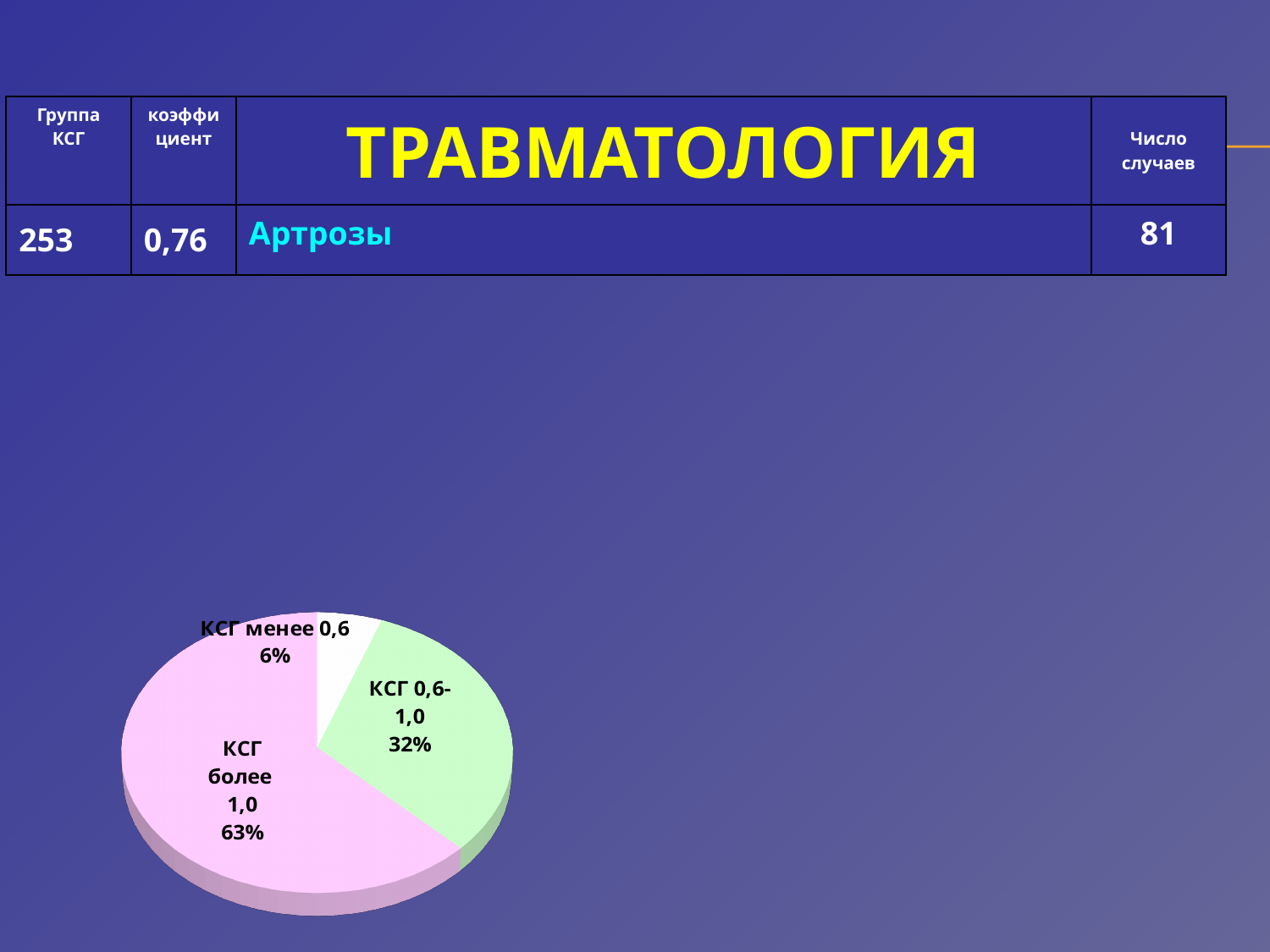
How many slices does the pie chart have? 3 Which slice of the pie chart is the largest? КСГ более 1,0 What kind of chart is shown on the slide? pie chart What is the difference in percentage points between the "КСГ 0,6-1,0" slice and the "КСГ менее 0,6" slice? 26 What is the difference in percentage points between the "КСГ более 1,0" slice and the "КСГ 0,6-1,0" slice? 31 What share of the pie does the slice "КСГ более 1,0" represent? 63% What share of the pie does the slice "КСГ 0,6-1,0" represent? 32% Which slice is larger: "КСГ 0,6-1,0" or "КСГ менее 0,6"? КСГ 0,6-1,0 What colour is the "КСГ 0,6-1,0" slice in the pie chart? light green What colour is the "КСГ более 1,0" slice in the pie chart? pink What share of the pie does the slice "КСГ менее 0,6" represent? 6% Which slice of the pie chart is the smallest? КСГ менее 0,6